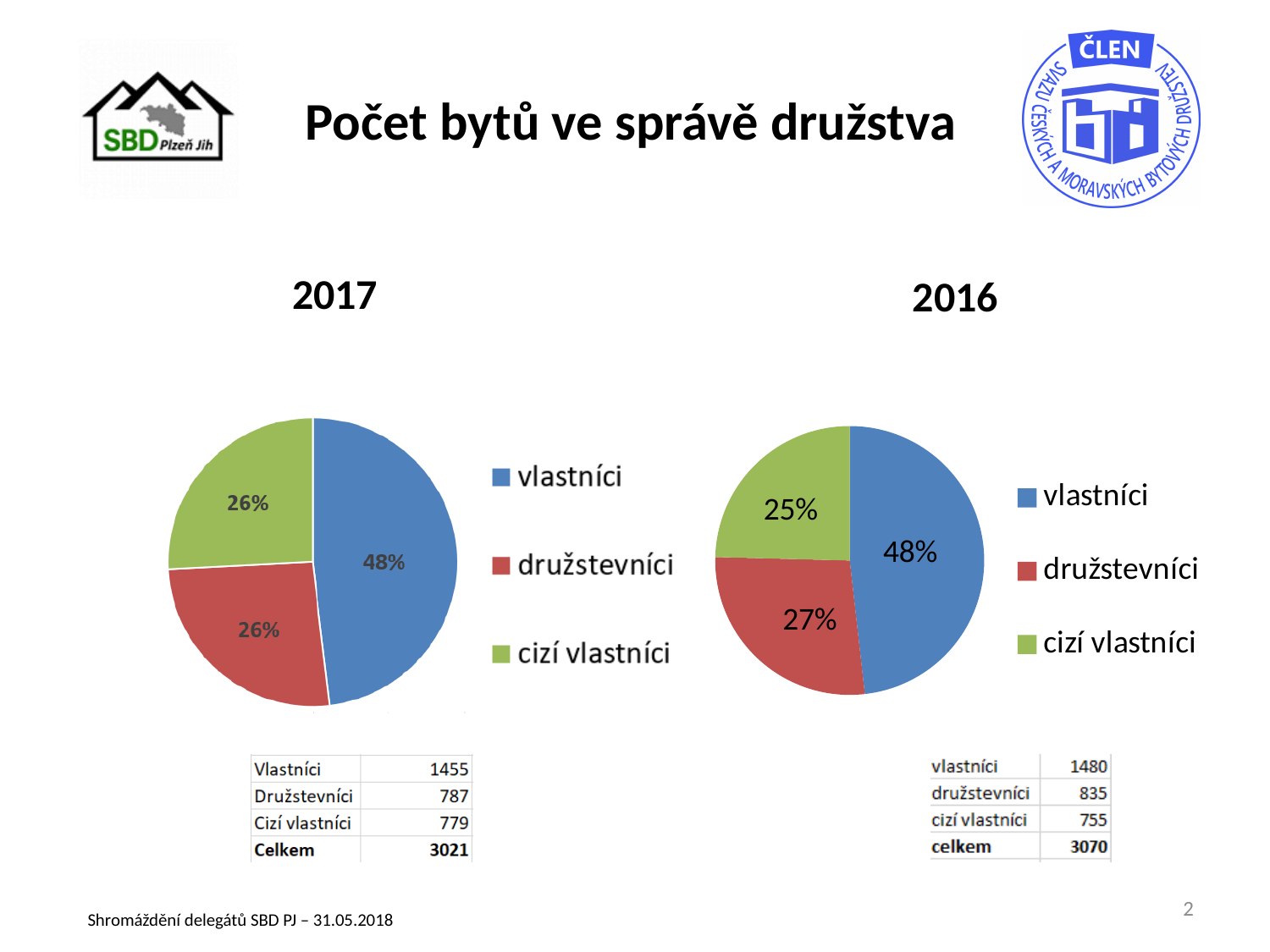
In the 2017 pie chart, what share of the pie is the vlastníci slice? 48% How many entries does the legend of the 2016 pie chart list? 3 In the 2016 pie chart, which category has the smallest slice? cizí vlastníci In the 2016 pie chart, which category has the largest slice? vlastníci In the 2016 pie chart, which slice is larger, družstevníci or cizí vlastníci? družstevníci In the 2016 pie chart, what share of the pie is the družstevníci slice? 27% In the 2017 pie chart, what share of the pie is the družstevníci slice? 26% What type of chart is used for the 2017 data on the left? pie chart In the 2017 pie chart, which colour represents cizí vlastníci? green In the 2016 pie chart, what is the difference in percentage points between the vlastníci slice and the družstevníci slice? 21 How many slices does the 2017 pie chart have? 3